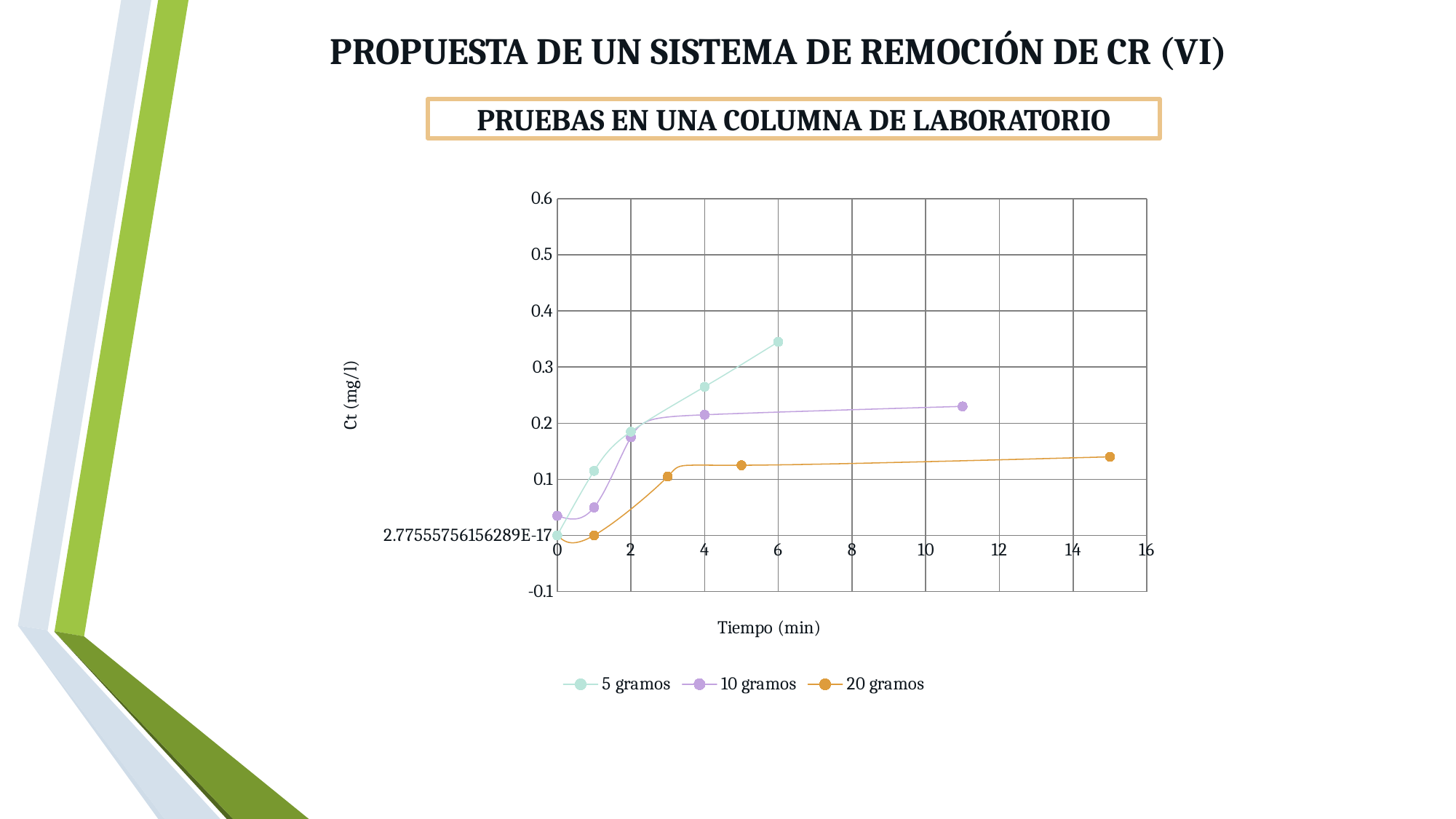
Which series reaches the highest Ct value on the chart? 5 gramos What are the three series named in the legend? 5 gramos, 10 gramos, 20 gramos What kind of chart is shown on the slide? line chart Is the value for 5 gramos at 4 min greater or less than 0.2? greater Is the value for 5 gramos at 6 min greater or less than 0.3? greater Is the value for 10 gramos at 11 min greater or less than 0.3? less At 4 min, which series has the larger value, 5 gramos or 10 gramos? 5 gramos What is the label of the x axis? Tiempo (min) How many series does the legend list? 3 Which series has the lowest values at its final point? 20 gramos Do the values for 5 gramos rise or fall as time increases? rise